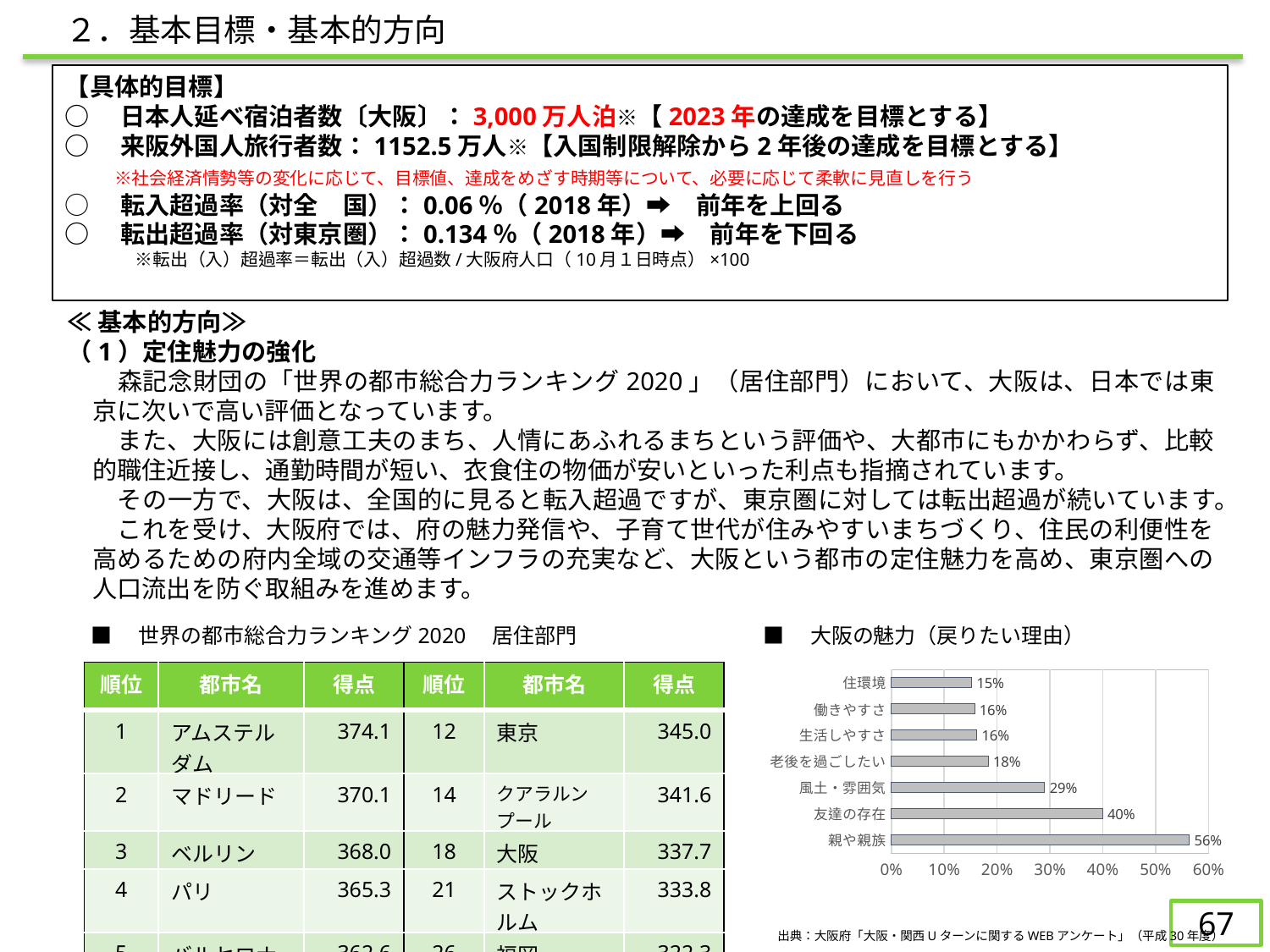
What is the value for 親や親族 in the chart 大阪の魅力（戻りたい理由）? 56% In the chart 大阪の魅力（戻りたい理由）, what is the difference between the values for 親や親族 and 友達の存在? 16% What is the maximum value shown on the x axis of the chart 大阪の魅力（戻りたい理由）? 60% Which category has the highest value in the chart 大阪の魅力（戻りたい理由）? 親や親族 Which category has the lowest value in the chart 大阪の魅力（戻りたい理由）? 住環境 What is the value for 友達の存在 in the chart 大阪の魅力（戻りたい理由）? 40% What is the value for 風土・雰囲気 in the chart 大阪の魅力（戻りたい理由）? 29% In the chart 大阪の魅力（戻りたい理由）, which is larger: 風土・雰囲気 or 老後を過ごしたい? 風土・雰囲気 What is the value for 住環境 in the chart 大阪の魅力（戻りたい理由）? 15% In the chart 大阪の魅力（戻りたい理由）, is the value for 友達の存在 greater or less than 30%? greater How many categories are shown in the chart 大阪の魅力（戻りたい理由）? 7 What kind of chart is 大阪の魅力（戻りたい理由）? bar chart